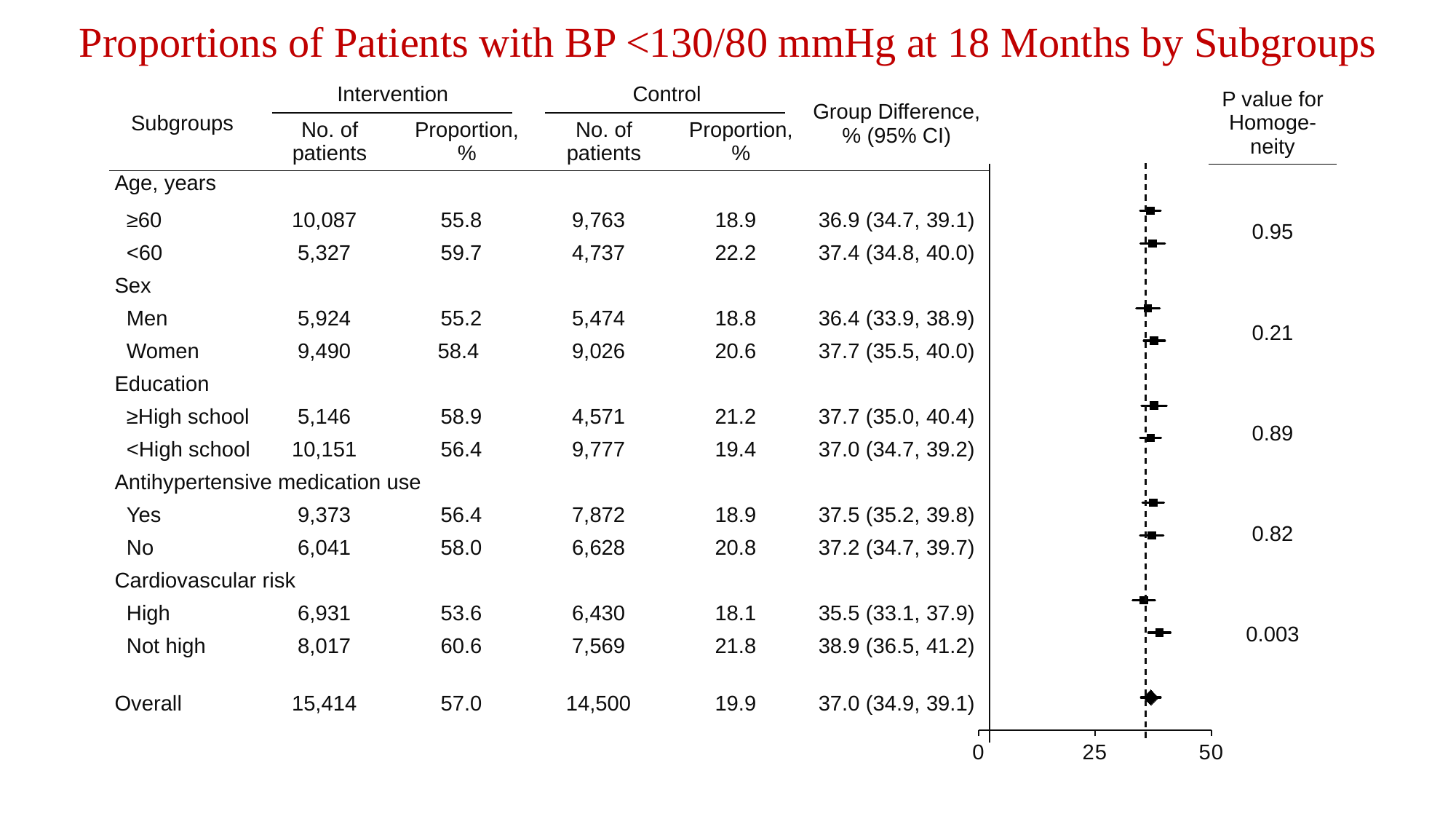
What is the P value for homogeneity for the cardiovascular risk subgroups? 0.003 Which subgroup has the largest group difference in the forest plot? Not high (cardiovascular risk) Which has the larger group difference, Men or Women? Women What tick values are shown on the x axis of the forest plot? 0, 25, 50 What is the difference between the group difference for Not high cardiovascular risk (38.9) and High cardiovascular risk (35.5)? 3.4 What kind of chart is shown on the right side of the slide? Forest plot What is the group difference, % (95% CI), for the Not high cardiovascular risk subgroup? 38.9 (36.5, 41.2) Which subgroup has the smallest group difference in the forest plot? High (cardiovascular risk) Is the group difference for the High cardiovascular risk subgroup greater or less than 50 on the forest plot axis? less What is the group difference, % (95% CI), for the Overall row? 37.0 (34.9, 39.1) How many subgroup points (excluding Overall) are plotted in the forest plot? 10 Is the group difference for the Overall row greater or less than 25 on the forest plot axis? greater